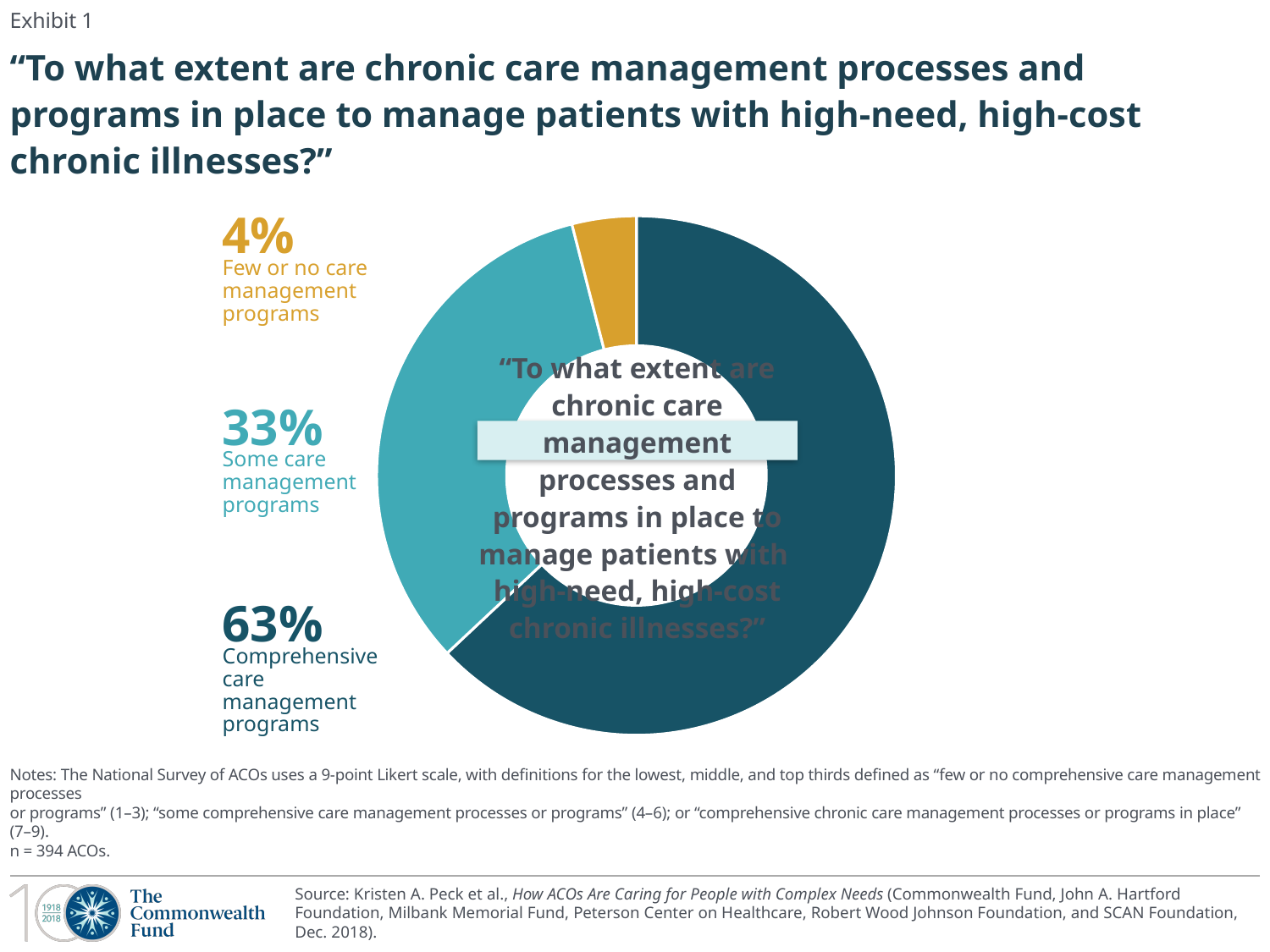
What percentage of ACOs reported comprehensive care management programs? 63% Which category has the smallest share of the chart? Few or no care management programs How many categories are shown in the chart? 3 Which is larger: the share for some care management programs or the share for few or no care management programs? Some care management programs Which category has the largest share of the chart? Comprehensive care management programs What percentage of ACOs reported few or no care management programs? 4% What is the difference in percentage points between some care management programs and few or no care management programs? 29 What kind of chart is shown on the slide? Pie chart (donut) What colour is the slice for few or no care management programs? Gold/yellow How many ACOs were surveyed according to the notes? 394 What is the difference in percentage points between comprehensive care management programs and some care management programs? 30 What percentage of ACOs reported some care management programs? 33%